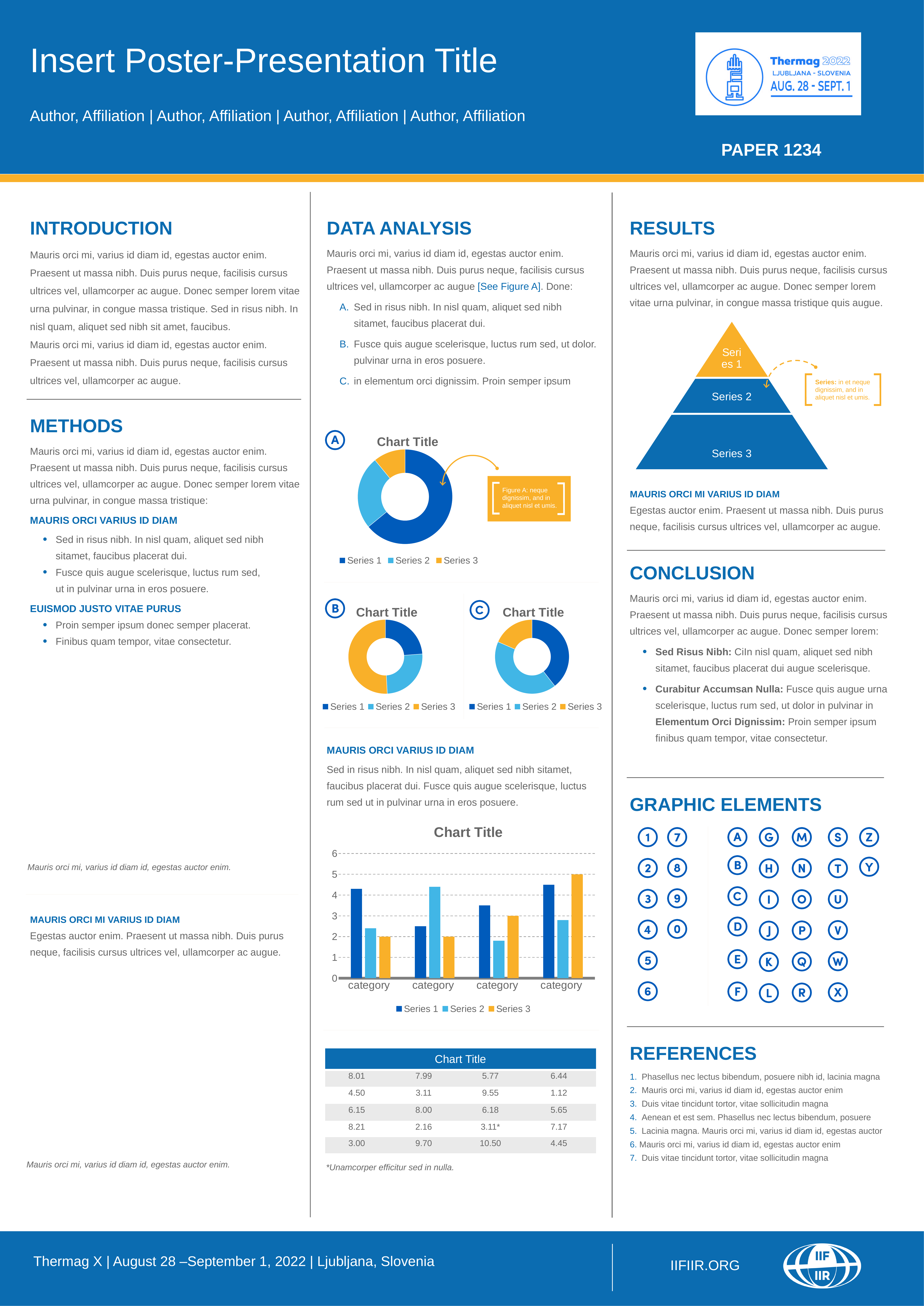
What kind of chart is the chart at the bottom of the Data Analysis column, above the table? bar chart How many series does the legend of the bar chart list? 3 How many categories are shown on the x axis of the bar chart? 4 In the bar chart, is the Series 2 value for the third category greater or less than 2? less In chart C, which series has the smallest slice? Series 3 In chart A, which series has the largest slice? Series 1 How many series does the legend of chart A list? 3 In chart A, which series has the smallest slice? Series 3 What kind of chart is chart A in the Data Analysis column? doughnut chart In the bar chart, is the Series 2 value for the second category greater or less than 4? greater In the bar chart, which series has the tallest bar in the fourth category? Series 3 In chart B, which series has the largest slice? Series 3